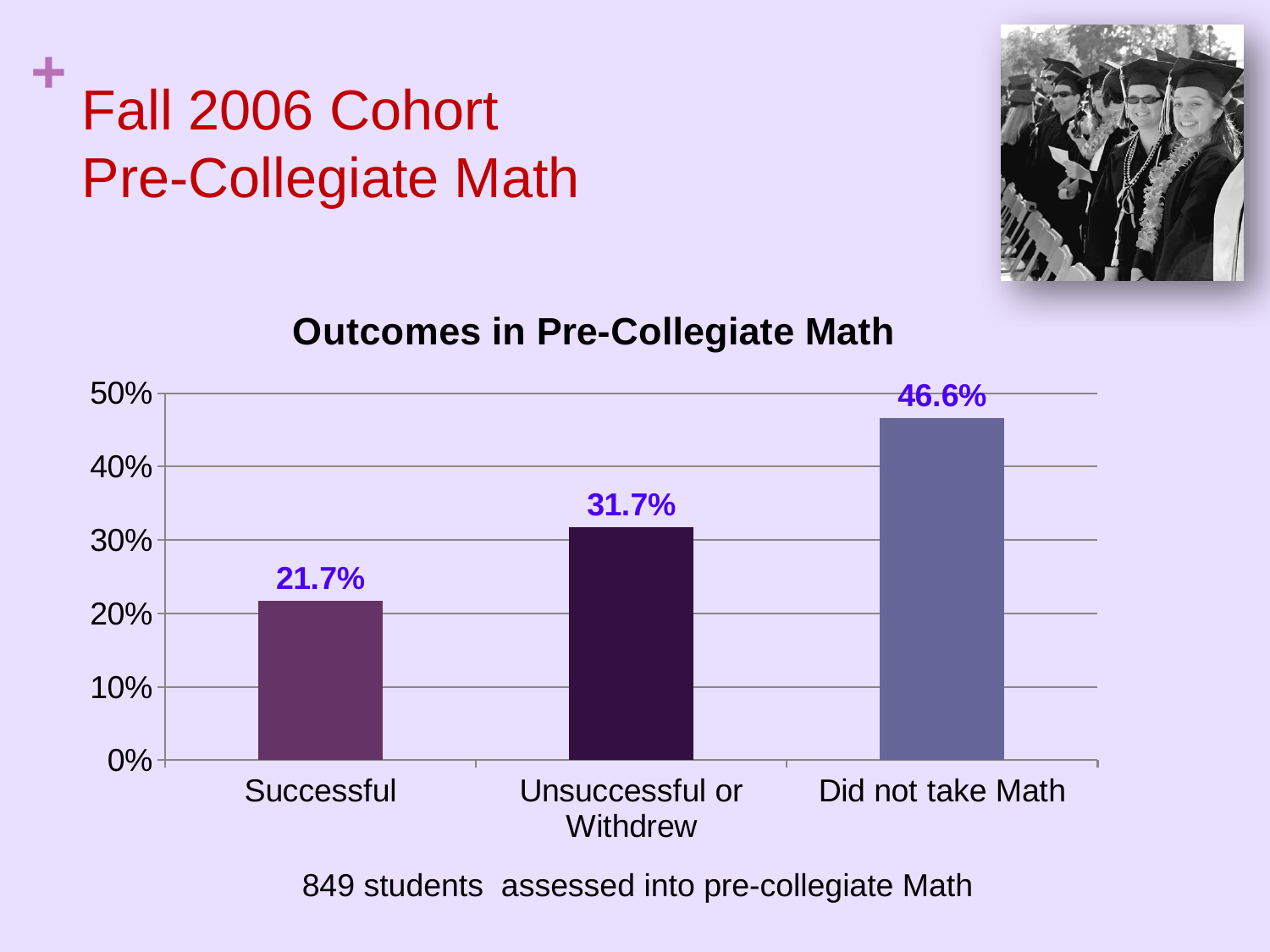
What percentage of students were Successful in pre-collegiate Math? 21.7% What is the difference between the Did not take Math value and the Successful value? 24.9% What is the title of the chart? Outcomes in Pre-Collegiate Math Which category has the lowest value? Successful How many categories are shown on the x axis? 3 Is the value for Did not take Math greater or less than 40%? greater Which is larger, the value for Successful or the value for Unsuccessful or Withdrew? Unsuccessful or Withdrew What is the difference between Unsuccessful or Withdrew and Successful? 10.0% What kind of chart is shown on the slide? bar chart Which category has the highest value? Did not take Math What is the value for Unsuccessful or Withdrew? 31.7% What percentage of students Did not take Math? 46.6%